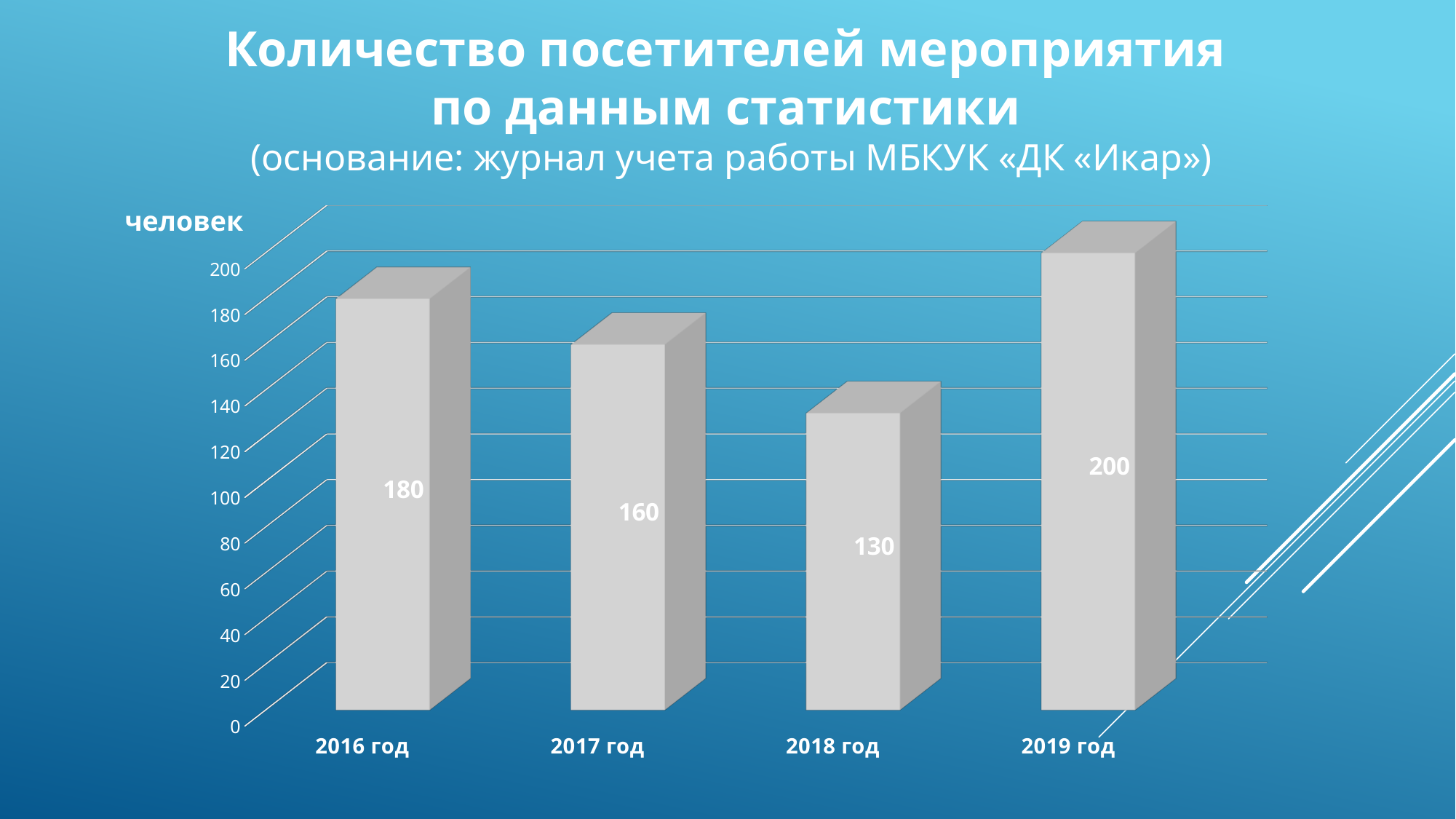
Which year has the lowest number of visitors? 2018 год How many years are shown on the chart? 4 What kind of chart is shown on the slide? Bar chart What is the number of visitors for 2016 год? 180 What is the number of visitors for 2019 год? 200 Which year had more visitors, 2016 год or 2017 год? 2016 год What is the difference in visitors between 2019 год and 2018 год? 70 Which year has the highest number of visitors? 2019 год Did the number of visitors rise or fall from 2016 год to 2018 год? Fall What is the number of visitors for 2018 год? 130 What unit label is shown on the vertical axis of the chart? человек What is the number of visitors for 2017 год? 160